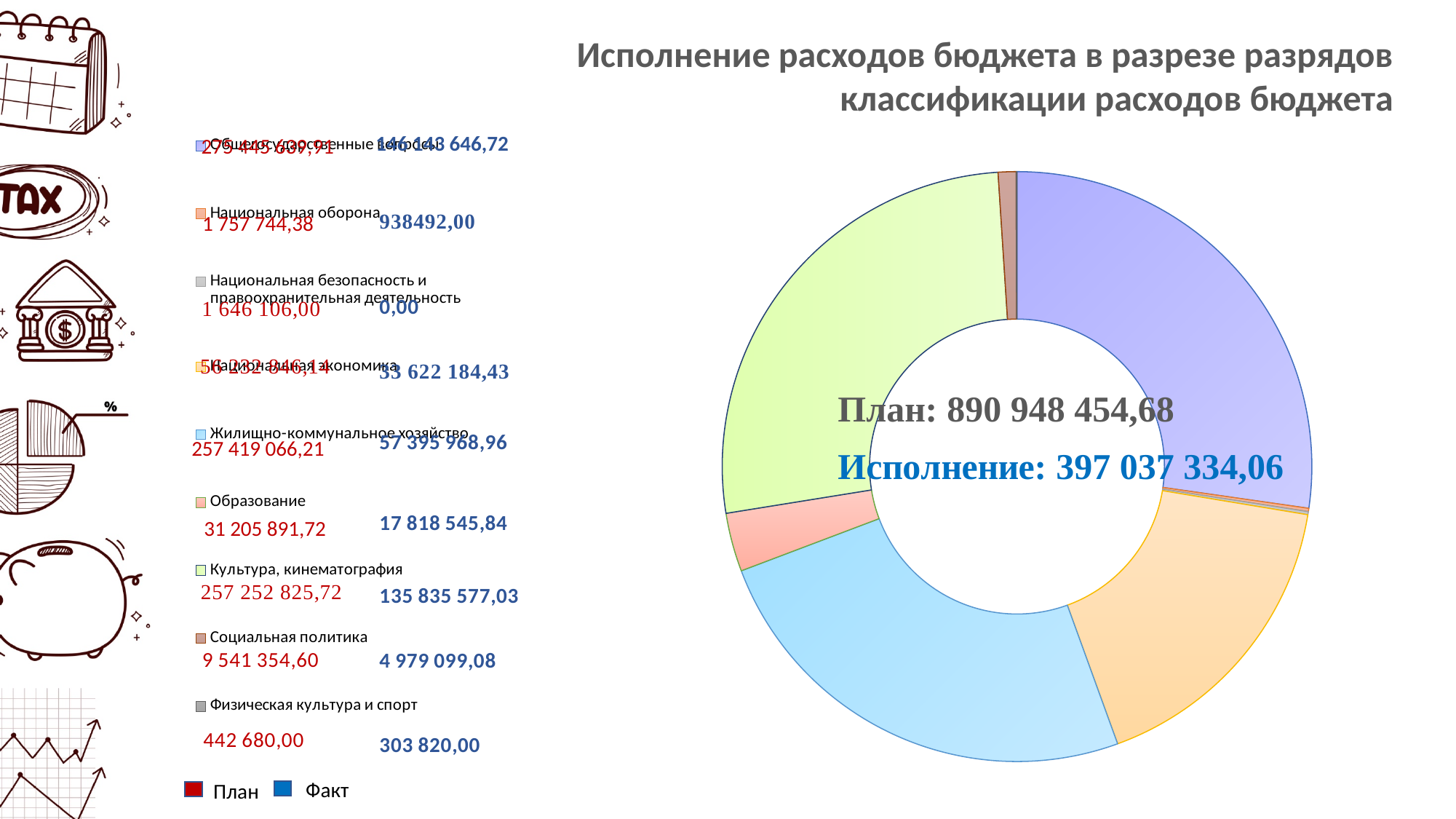
How many series are listed in the План/Факт legend at the bottom? 2 What is the title of the chart? Исполнение расходов бюджета в разрезе разрядов классификации расходов бюджета What type of chart is shown on the slide? Doughnut (pie) chart What is the total План value shown in the centre of the chart? 890 948 454,68 What is the План value for Культура, кинематография? 257 252 825,72 What is the difference between the План and Факт values for Физическая культура и спорт? 138 860,00 How many categories does the chart legend list? 9 Which has the larger План value: Культура, кинематография or Образование? Культура, кинематография What is the Факт value for Образование? 17 818 545,84 What is the Исполнение value shown in the centre of the chart? 397 037 334,06 What is the difference between the План and Факт values for Социальная политика? 4 562 255,52 What is the Факт value for Национальная безопасность и правоохранительная деятельность? 0,00